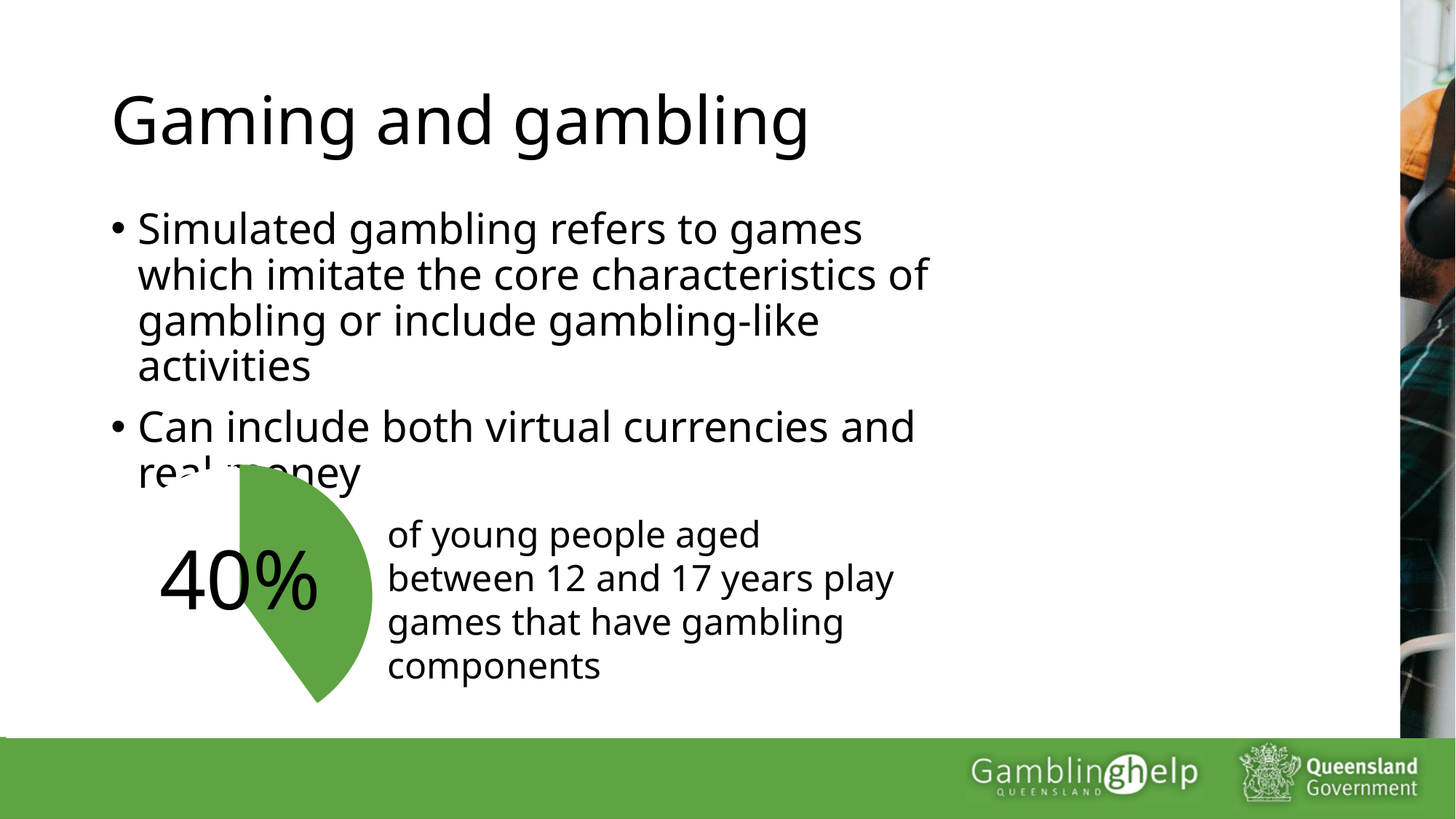
What share of the pie does the green slice represent? 40% Is the share shown by the green slice greater or less than 50%? less What colour is the highlighted slice of the pie chart? green According to the text next to the pie chart, what does the 40% represent? young people aged between 12 and 17 years who play games that have gambling components What kind of chart is shown on the slide? pie chart How many slices are visibly coloured in the pie chart? 1 What percentage is printed on the pie chart? 40%